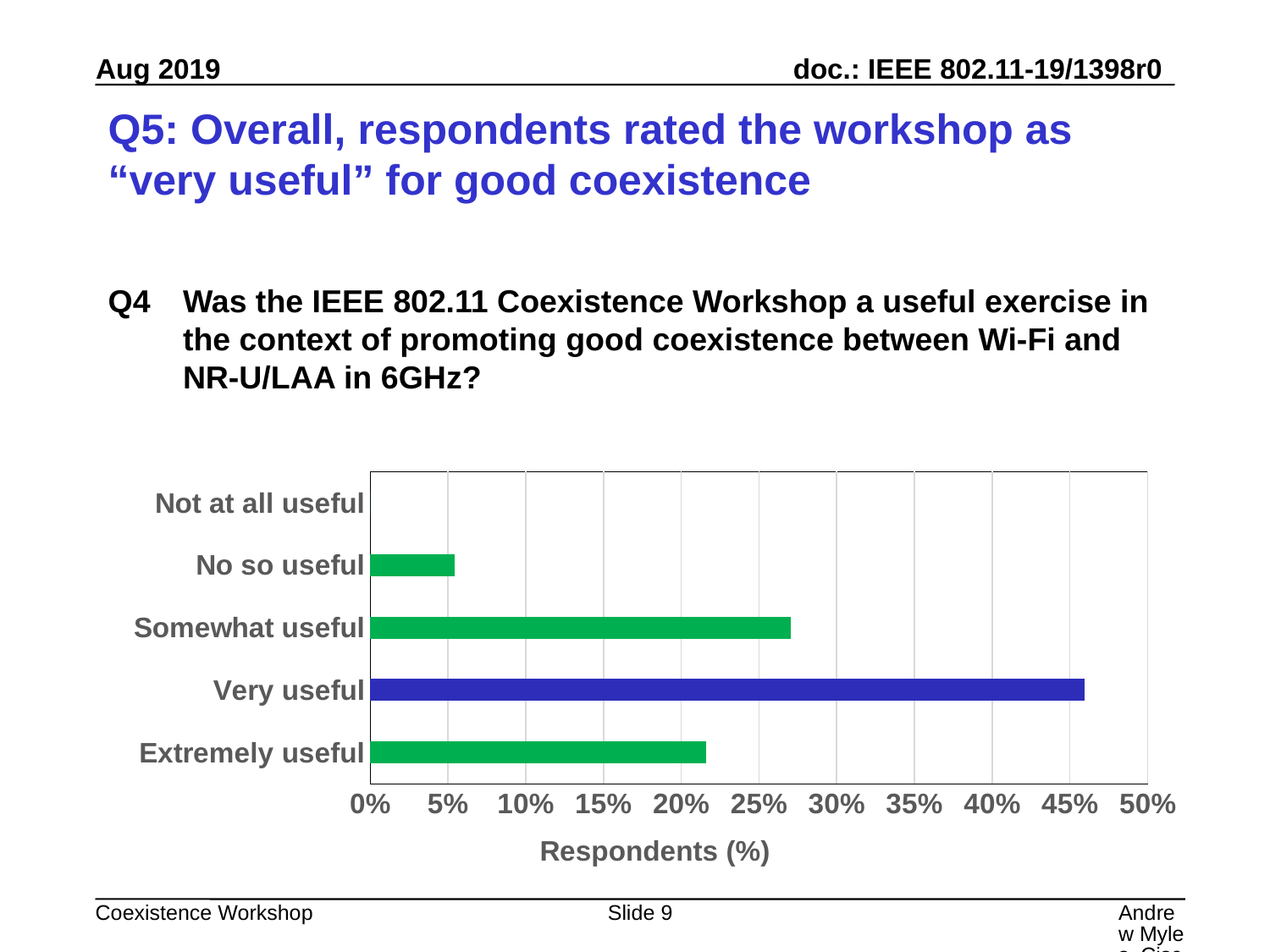
Is the value for Extremely useful greater or less than 25%? less Is the value for Very useful greater or less than 40%? greater Is the value for Somewhat useful greater or less than 25%? greater Which has a larger share of respondents, Somewhat useful or Extremely useful? Somewhat useful Which has a larger share of respondents, No so useful or Extremely useful? Extremely useful How many response categories are listed on the vertical axis of the chart? 5 What is the title of the horizontal axis of the chart? Respondents (%) Which response category has the highest share of respondents? Very useful Which response category's bar is coloured blue rather than green? Very useful What kind of chart is shown on the slide? bar chart Which response category has the lowest share of respondents? Not at all useful